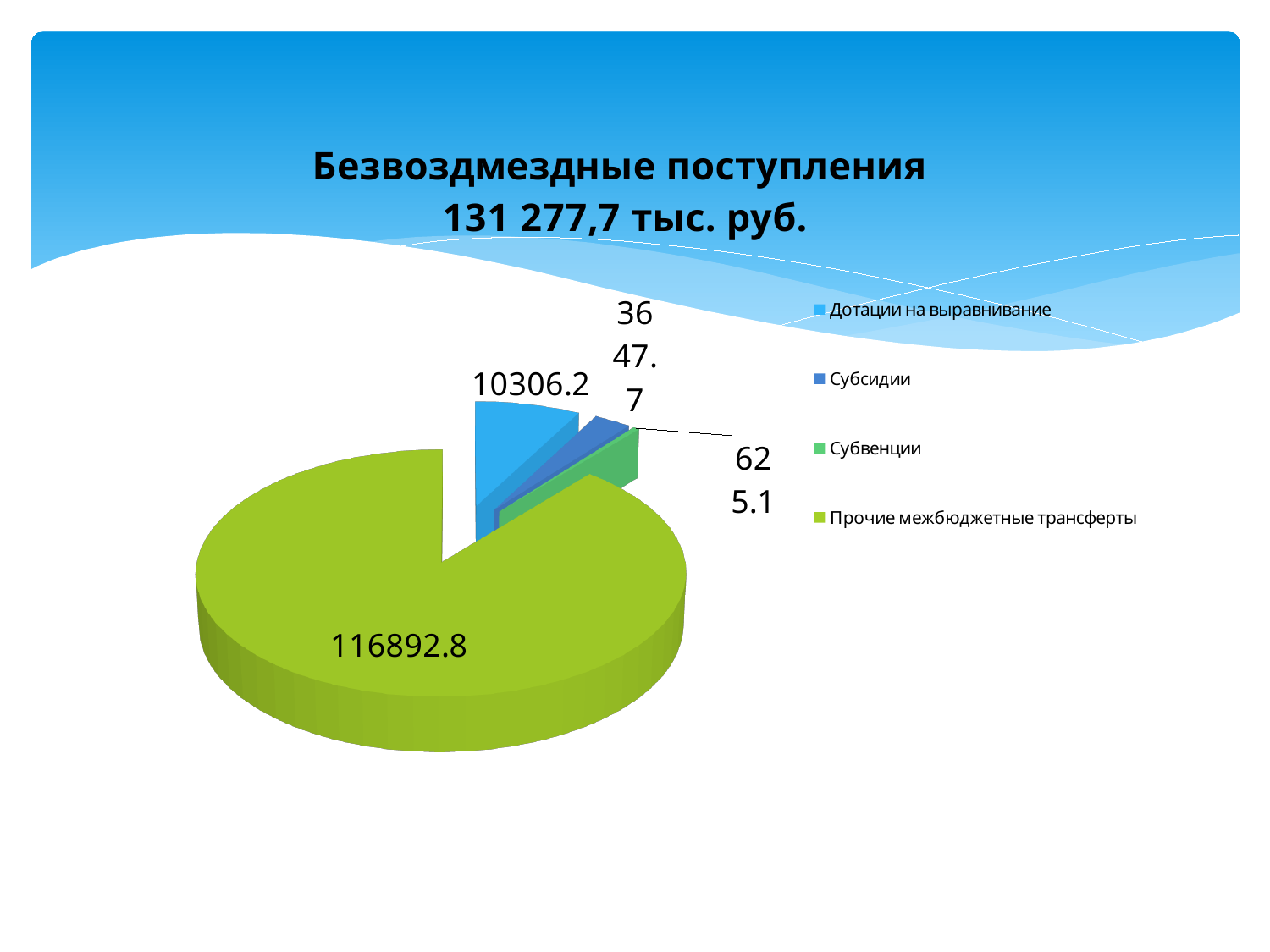
How many categories does the pie chart have? 4 What is the value for Субсидии? 3647.7 What is the difference between Прочие межбюджетные трансферты and Дотации на выравнивание? 106586.6 Which category has the largest slice of the pie? Прочие межбюджетные трансферты What is the value for Прочие межбюджетные трансферты? 116892.8 What is the title of the chart? Безвоздмездные поступления 131 277,7 тыс. руб. What type of chart is shown on the slide? pie chart What is the value for Дотации на выравнивание? 10306.2 Which category has the smallest slice of the pie? Субвенции Which is larger, Дотации на выравнивание or Субсидии? Дотации на выравнивание What is the value for Субвенции? 625.1